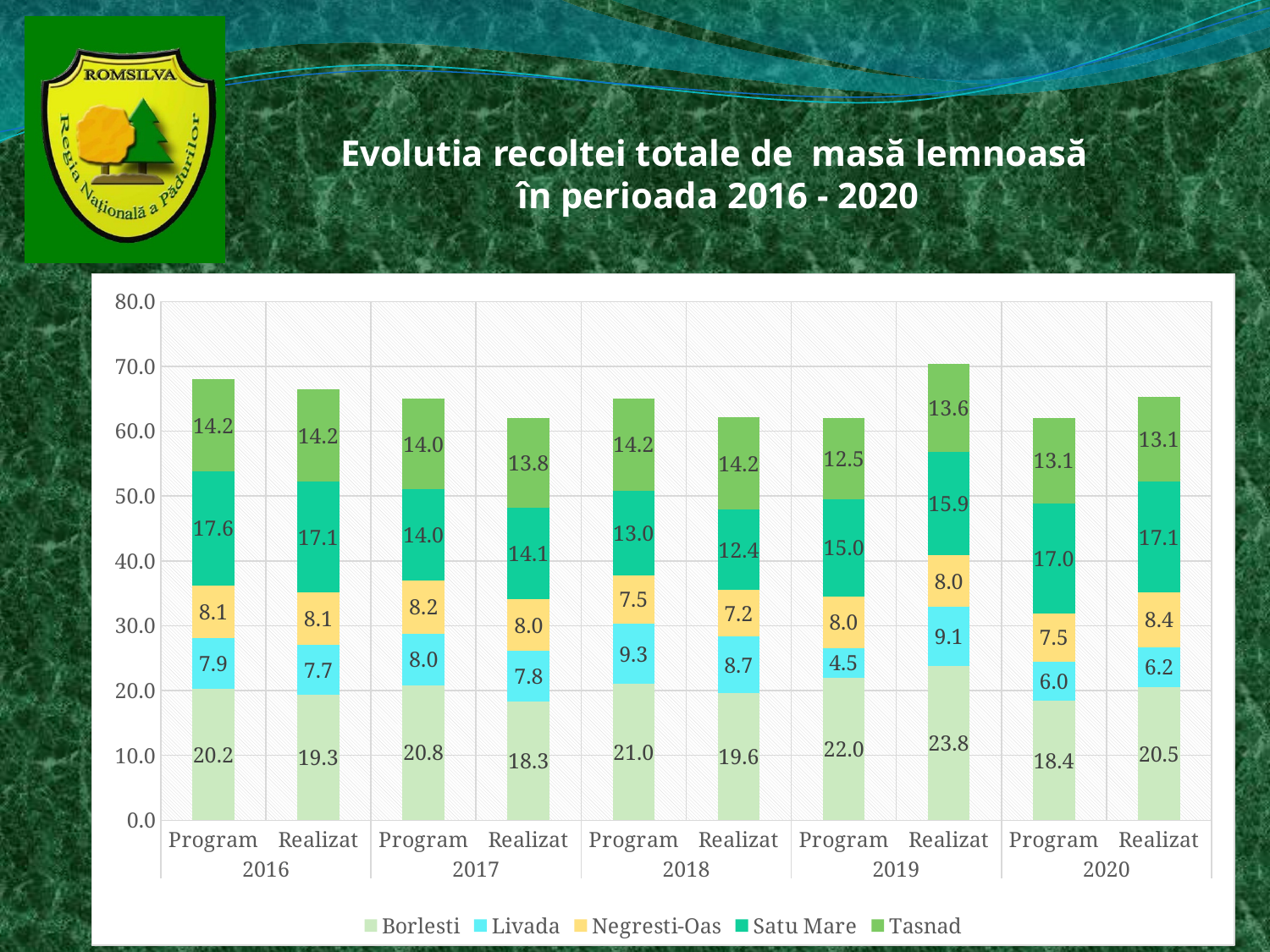
What is the value for Livada in the 2019 Program bar? 4.5 Which bar has the highest Borlesti value? 2019 Realizat How many bars are plotted in the chart? 10 Which bar has the lowest Livada value? 2019 Program What type of chart is shown on the slide? stacked bar chart What is the difference between the Borlesti values for 2018 Program and 2018 Realizat? 1.4 What is the value for Tasnad in the 2020 Realizat bar? 13.1 What is the total of the 2016 Program stacked bar? 68.0 What is the value for Satu Mare in the 2016 Program bar? 17.6 Which is larger, the Satu Mare value for 2019 Realizat or for 2019 Program? 2019 Realizat How many series does the legend list? 5 What is the value for Borlesti in the 2019 Realizat bar? 23.8